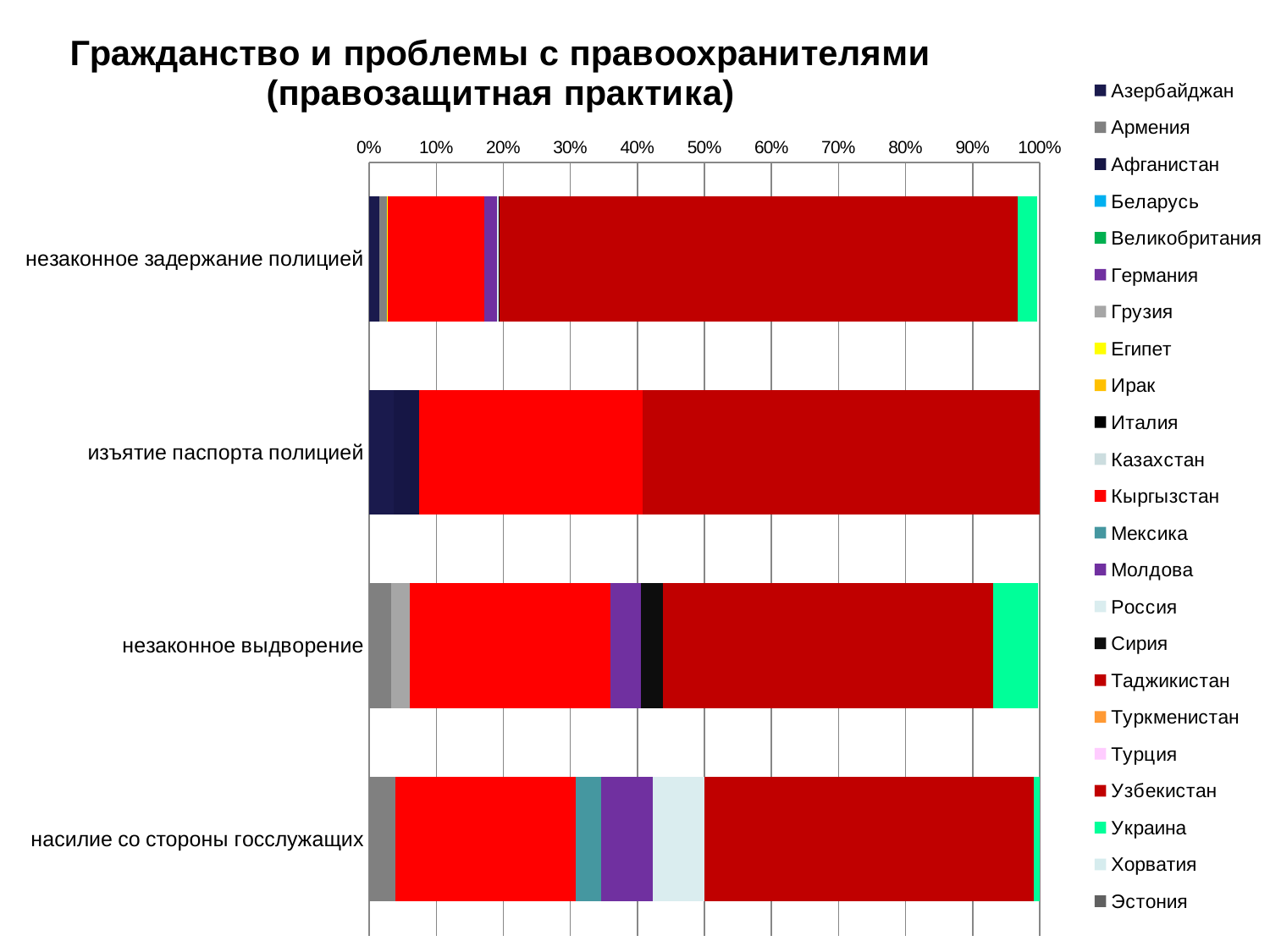
What kind of chart is shown on the slide? stacked bar chart In which category is the Кыргызстан share of the bar the smallest? незаконное задержание полицией Is the Кыргызстан share of the bar for 'изъятие паспорта полицией' greater or less than 20%? greater What is the highest value shown on the horizontal axis of the chart? 100% Is the Кыргызстан share of the bar for 'незаконное задержание полицией' greater or less than 20%? less Is the Кыргызстан share of the bar for 'незаконное выдворение' greater or less than 40%? less What is the total of the stacked bar for 'изъятие паспорта полицией'? 100% What is the title of the chart? Гражданство и проблемы с правоохранителями (правозащитная практика) How many categories are plotted on the vertical axis of the chart? 4 Which is larger: the Кыргызстан share in 'изъятие паспорта полицией' or in 'незаконное задержание полицией'? изъятие паспорта полицией How many series does the chart legend list? 23